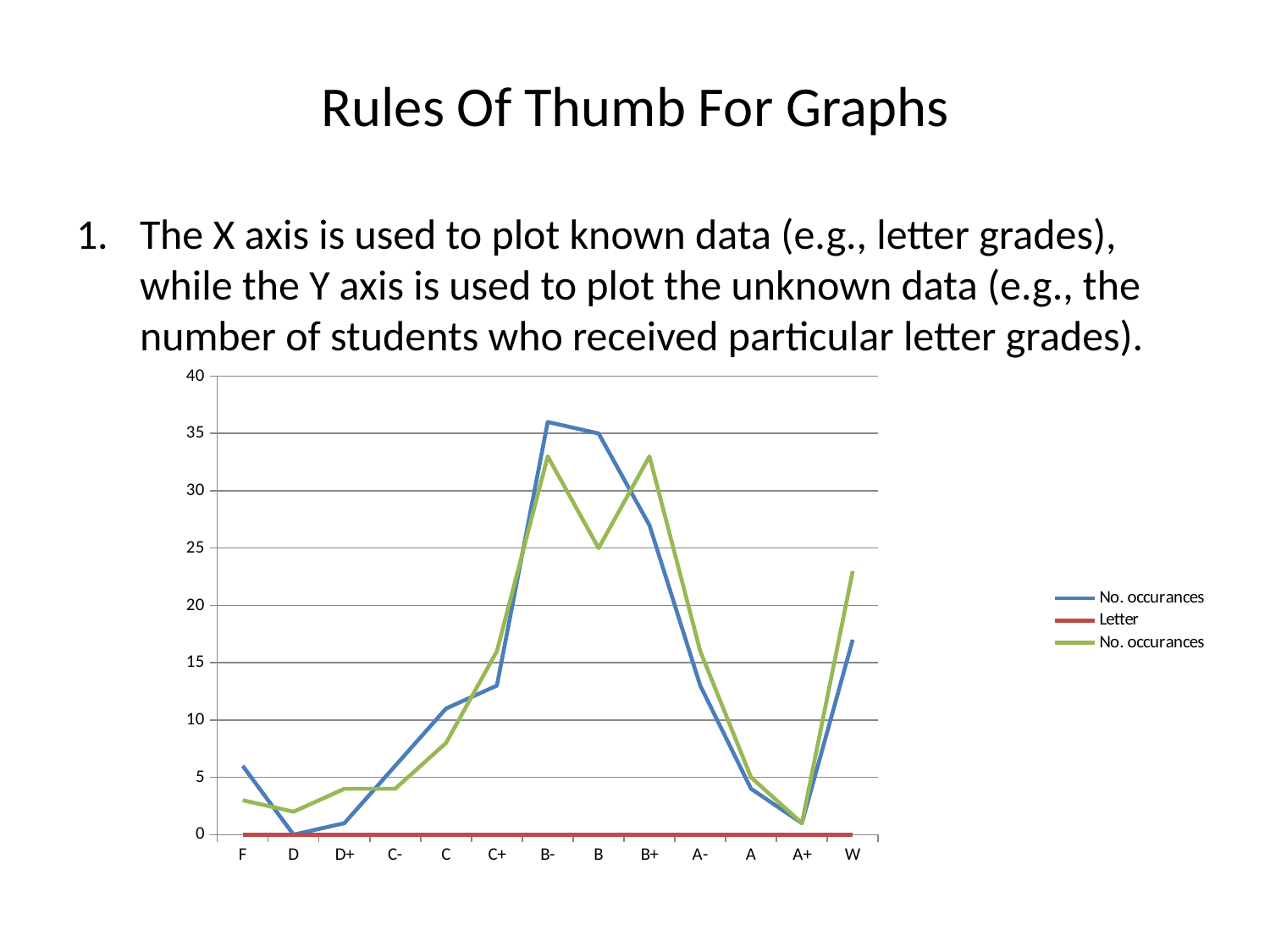
Is the value of the green 'No. occurances' line at B+ greater or less than 30? greater At grade B, which line is higher: the blue 'No. occurances' line or the green 'No. occurances' line? the blue line What colour is the 'Letter' series in the chart's legend? red At which letter grade does the blue 'No. occurances' line reach its highest value? B- What kind of chart is shown on the slide? line chart How many series does the chart's legend list? 3 Is the value of the green 'No. occurances' line at C greater or less than 10? less Does the blue 'No. occurances' line rise or fall from B- to A+? fall Is the value of the green 'No. occurances' line at W greater or less than 20? greater How many categories are shown along the x axis of the chart? 13 At grade W, which line is higher: the blue 'No. occurances' line or the green 'No. occurances' line? the green line